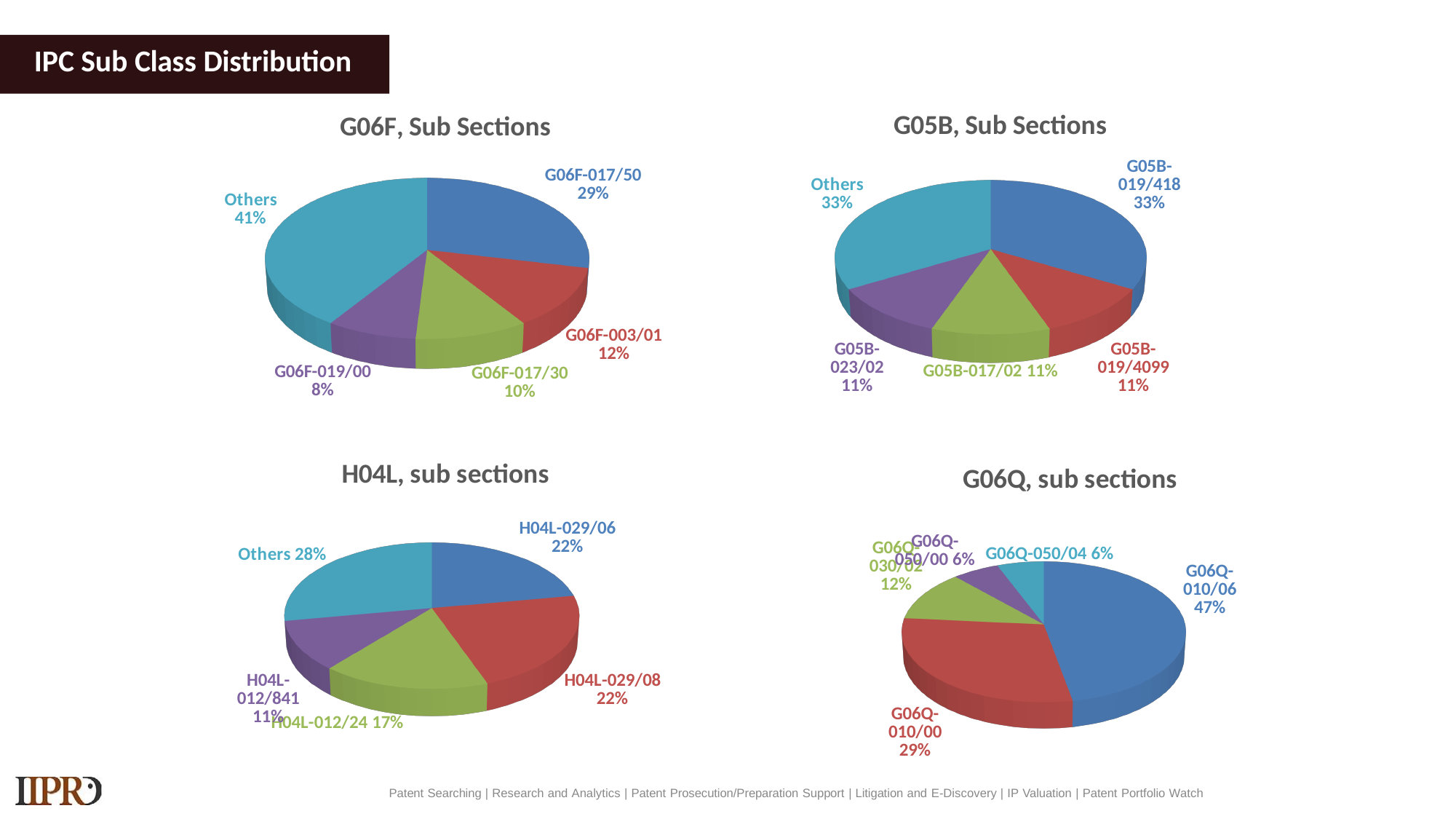
What type of chart is used for the four charts on this slide? Pie chart In the G06F, Sub Sections chart, what is the difference between the Others share and the G06F-017/50 share? 12 percentage points In the H04L, sub sections chart, which slice is the largest? Others In the G06F, Sub Sections chart, which slice is the smallest? G06F-019/00 In the H04L, sub sections chart, what share does H04L-012/24 have? 17% How many slices does the G05B, Sub Sections pie chart have? 5 In the G05B, Sub Sections chart, what share does G05B-019/4099 have? 11% In the G06Q, sub sections chart, what share does G06Q-030/02 have? 12% In the H04L, sub sections chart, which is larger, H04L-012/24 or H04L-012/841? H04L-012/24 In the G06Q, sub sections chart, what is the difference between the G06Q-010/06 share and the G06Q-010/00 share? 18 percentage points In the G06Q, sub sections chart, which slice is the largest? G06Q-010/06 In the G06F, Sub Sections chart, what share does G06F-017/50 have? 29%